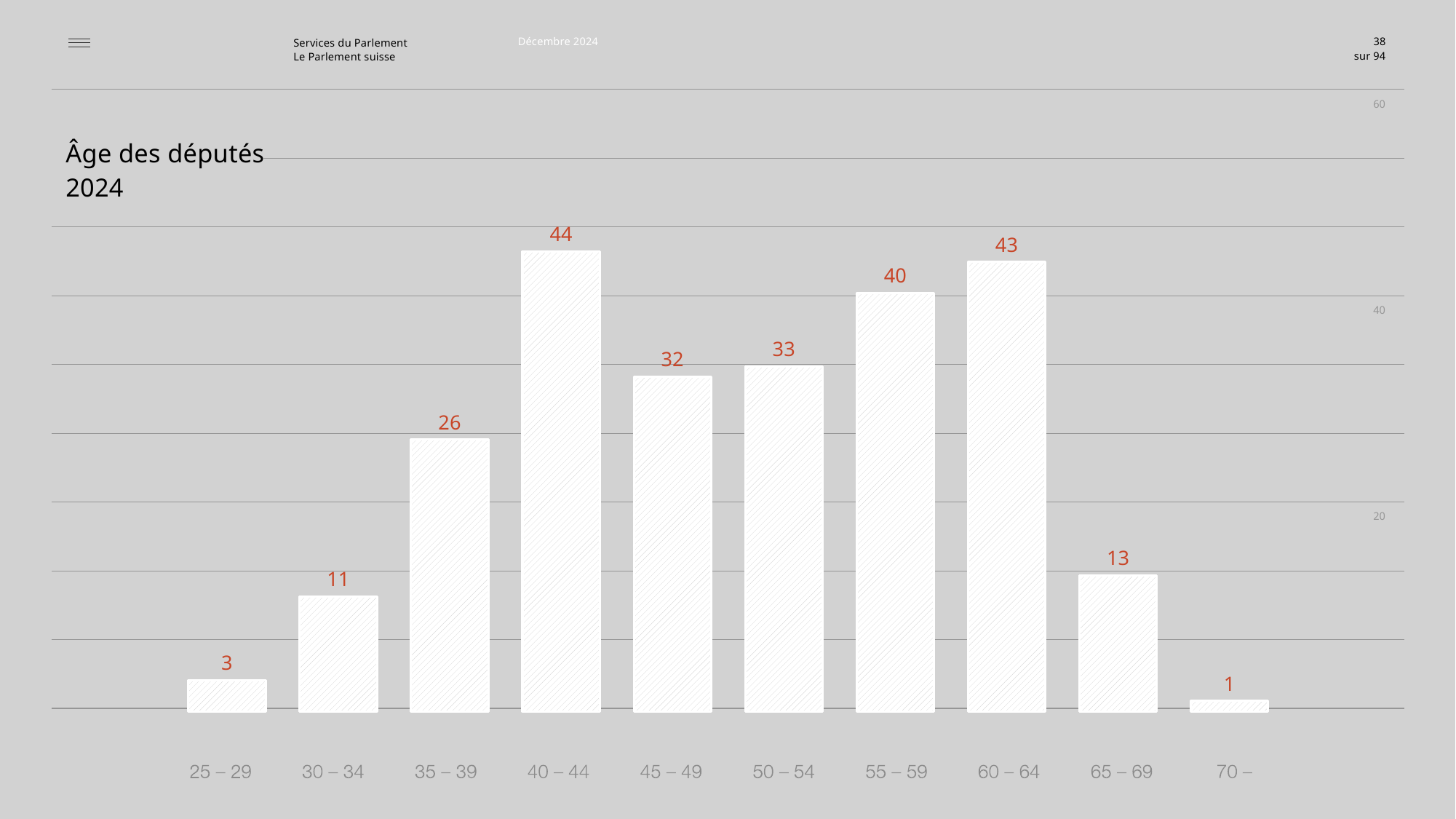
What is the difference between the values for 30 – 34 and 25 – 29? 8 Do the values rise or fall from 25 – 29 to 40 – 44? rise What is the value for the 40 – 44 age group? 44 What kind of chart is shown on the slide? bar chart How many age groups are shown on the chart? 10 Which is larger, the value for 35 – 39 or the value for 45 – 49? 45 – 49 What is the value for the 65 – 69 age group? 13 Is the value for 50 – 54 greater or less than 20? greater What is the difference between the values for 60 – 64 and 55 – 59? 3 What is the title of the chart? Âge des députés 2024 Which age group has the highest value? 40 – 44 Which age group has the lowest value? 70 –